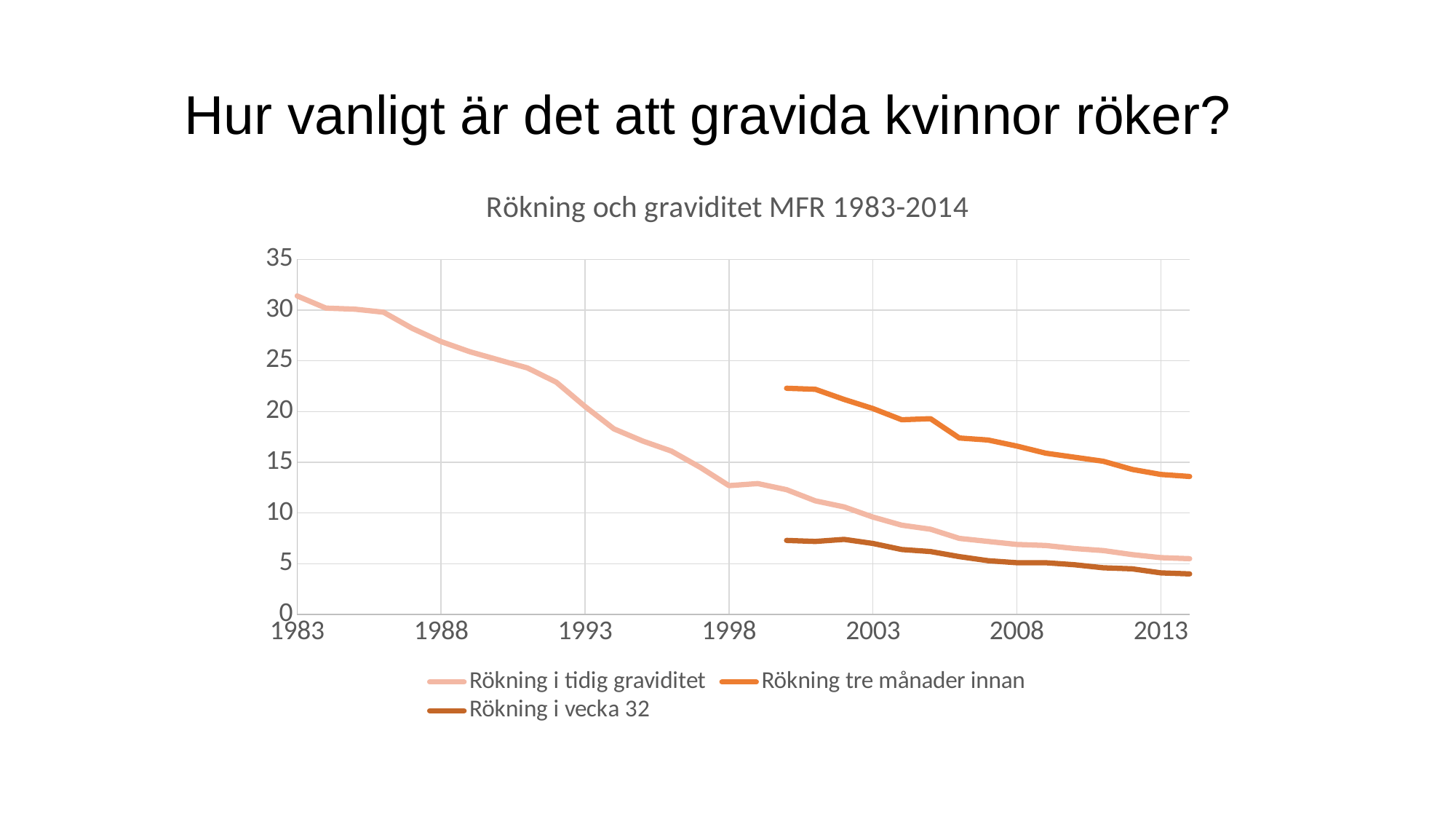
How many series does the legend list? 3 Does the value for Rökning tre månader innan rise or fall over the years shown? Fall What kind of chart is shown on the slide? Line chart Which series has data starting in 1983? Rökning i tidig graviditet In 2008, which series has the higher value: Rökning tre månader innan or Rökning i tidig graviditet? Rökning tre månader innan Is the value for Rökning tre månader innan in 2013 greater or less than 15? less Is the value for Rökning i vecka 32 in 2013 greater or less than 5? less Is the value for Rökning i tidig graviditet in 1983 greater or less than 30? greater Does the value for Rökning i tidig graviditet rise or fall from 1983 to 2013? Fall What is the title of the chart? Rökning och graviditet MFR 1983-2014